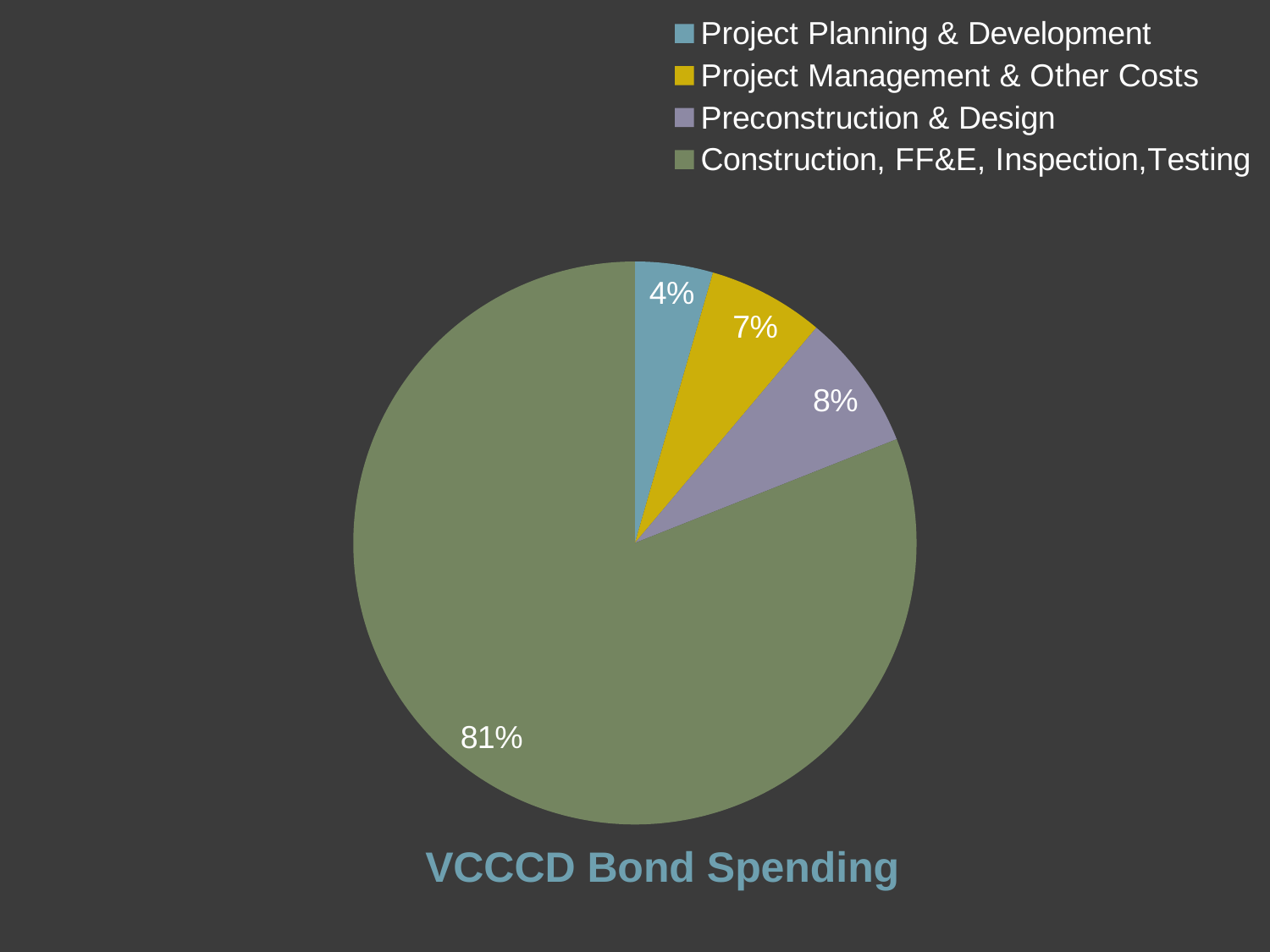
What type of chart is shown on the slide? Pie chart What share of VCCCD Bond Spending goes to Preconstruction & Design? 8% What is the difference in percentage points between the Preconstruction & Design slice and the Project Planning & Development slice? 4 What share of VCCCD Bond Spending goes to Project Management & Other Costs? 7% How many slices does the VCCCD Bond Spending pie chart have? 4 What is the title of the chart? VCCCD Bond Spending What share of VCCCD Bond Spending goes to Construction, FF&E, Inspection, Testing? 81% Which colour represents Project Management & Other Costs in the legend? Yellow Which is larger: the Project Management & Other Costs slice or the Preconstruction & Design slice? Preconstruction & Design Which category has the largest slice of the VCCCD Bond Spending pie? Construction, FF&E, Inspection, Testing Which category has the smallest slice of the VCCCD Bond Spending pie? Project Planning & Development